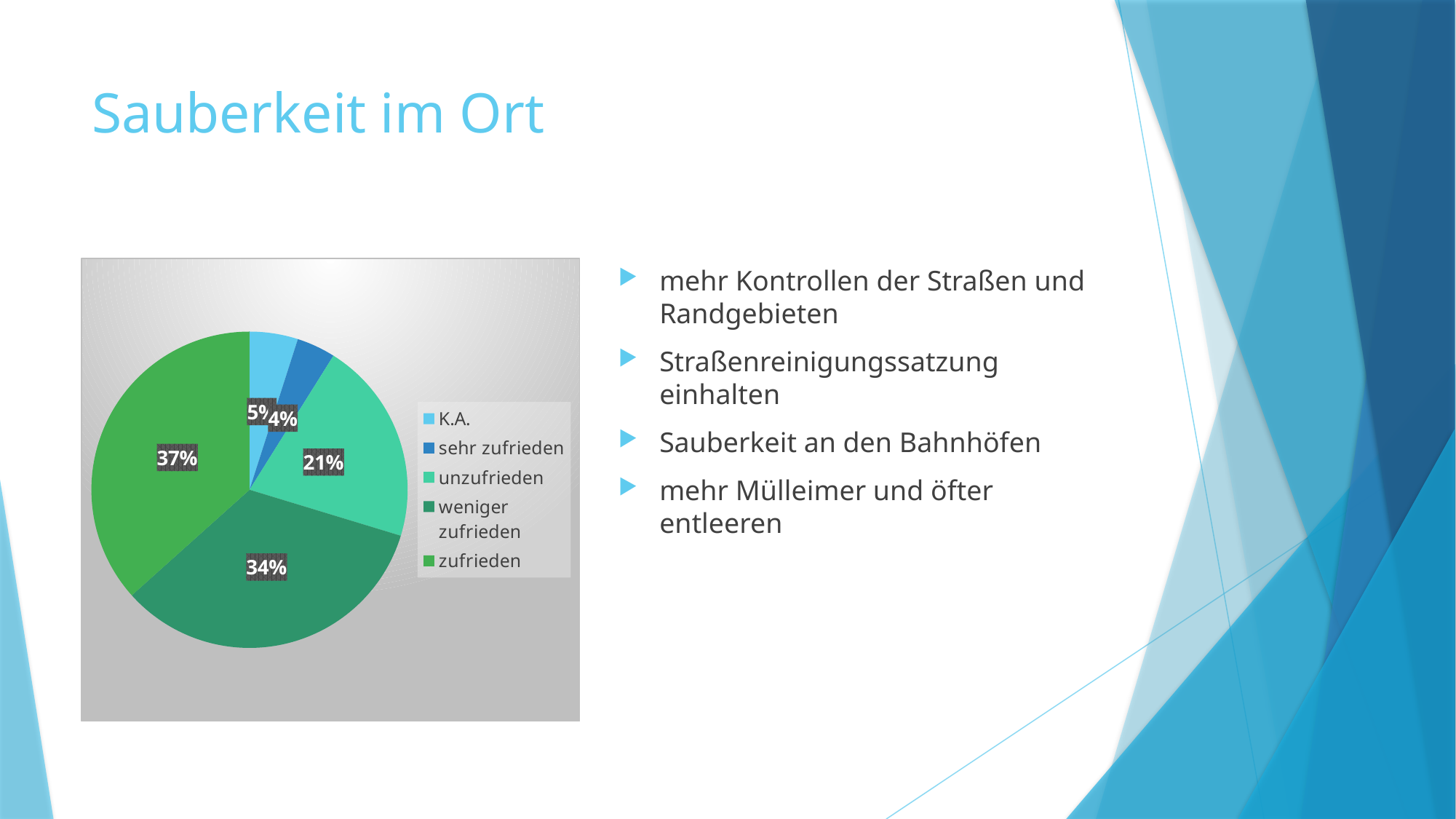
What share of the pie does "unzufrieden" have? 21% How many categories does the pie chart show? 5 What share of the pie does "weniger zufrieden" have? 34% What kind of chart is shown on the slide? pie chart What is the difference between the shares of "zufrieden" and "unzufrieden"? 16% What share of the pie does "sehr zufrieden" have? 4% Which category has the smallest slice of the pie? sehr zufrieden Which category has the largest slice of the pie? zufrieden Which is larger, the share of "weniger zufrieden" or the share of "unzufrieden"? weniger zufrieden Which legend entry is shown in the darkest green colour? weniger zufrieden